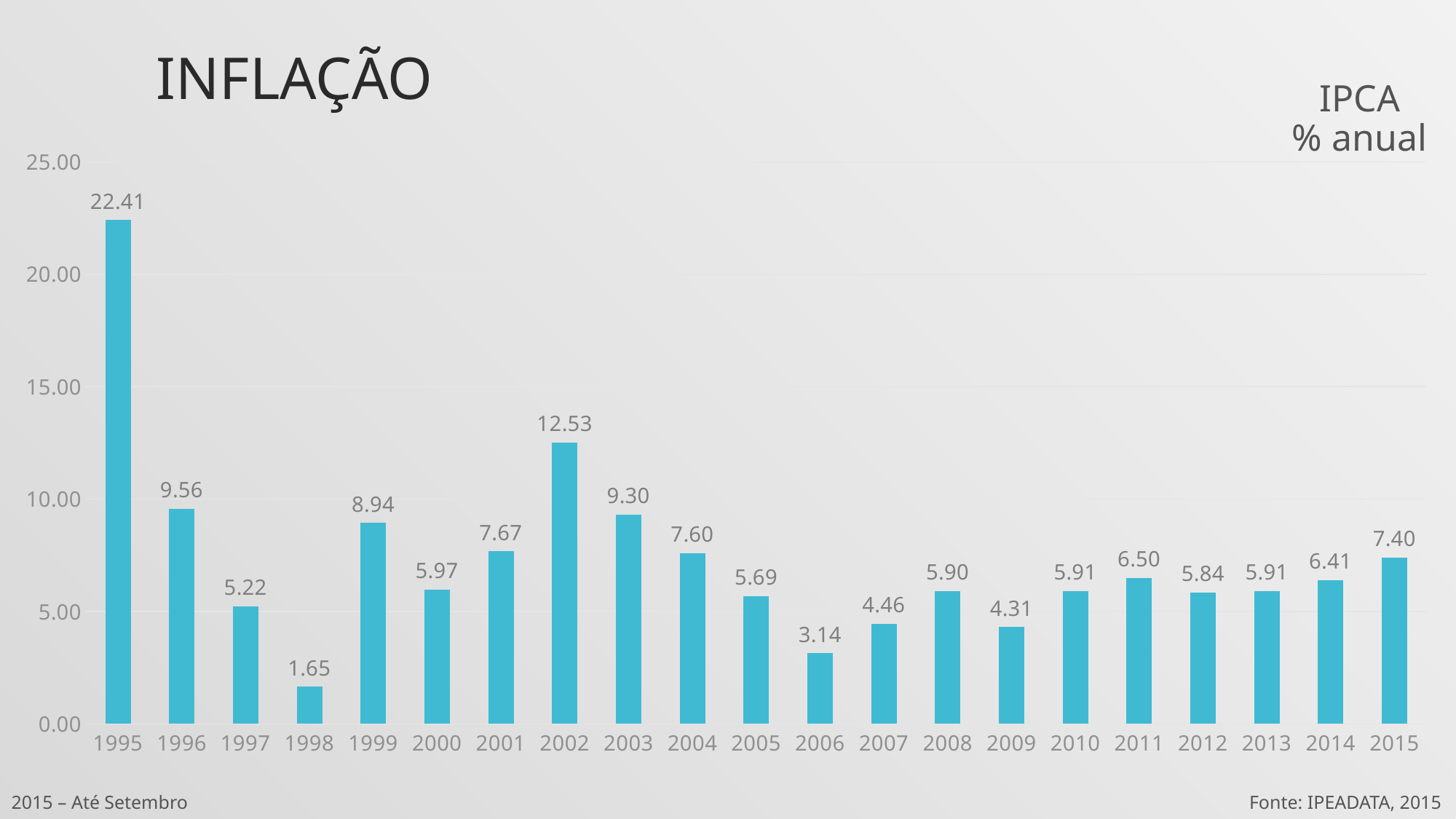
What is the title of the slide? INFLAÇÃO What is the IPCA value for 2002? 12.53 Is the IPCA value for 1999 greater or less than 10.00? less Do the IPCA values rise or fall from 1995 to 1998? fall Which year has the lowest IPCA value? 1998 What is the difference between the IPCA values for 1995 and 1996? 12.85 What kind of chart is shown on the slide? bar chart Which year has the highest IPCA value? 1995 What is the IPCA value for 2006? 3.14 Which year has a higher IPCA value, 2003 or 2004? 2003 What is the IPCA value for 2015? 7.40 How many years are shown on the x axis? 21